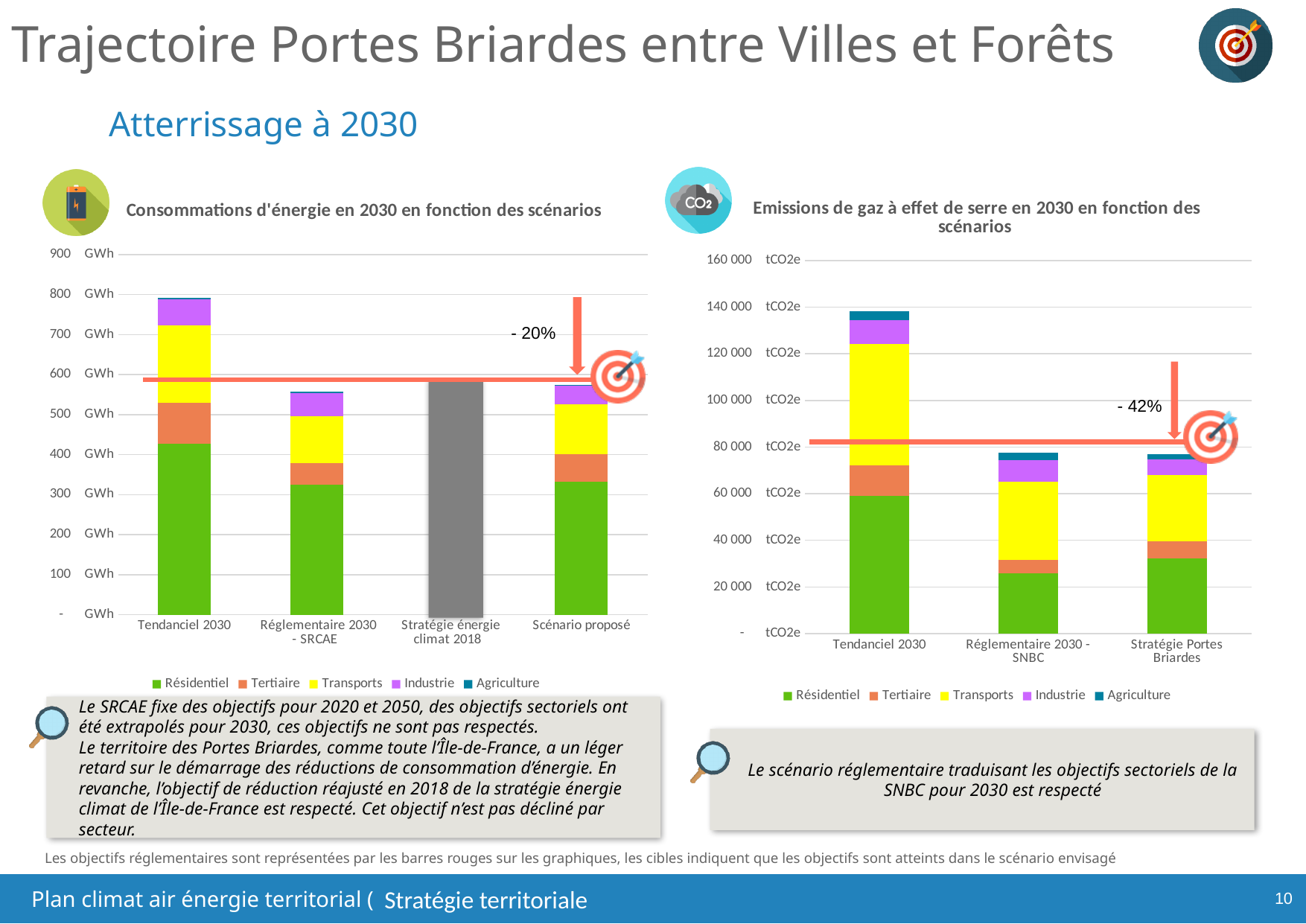
What kind of chart is the 'Consommations d'énergie en 2030 en fonction des scénarios' chart? Stacked bar chart In the 'Consommations d'énergie en 2030 en fonction des scénarios' chart, which scenario has the highest total energy consumption? Tendanciel 2030 In the 'Consommations d'énergie en 2030 en fonction des scénarios' chart, is the total for Scénario proposé greater or less than 600 GWh? less What percentage reduction is annotated with the red arrow on the 'Emissions de gaz à effet de serre en 2030 en fonction des scénarios' chart? - 42% How many series does the legend of the 'Emissions de gaz à effet de serre en 2030 en fonction des scénarios' chart list? 5 In the 'Emissions de gaz à effet de serre en 2030 en fonction des scénarios' chart, is the total for Stratégie Portes Briardes greater or less than 80 000 tCO2e? less How many scenario categories are shown on the x axis of the 'Emissions de gaz à effet de serre en 2030 en fonction des scénarios' chart? 3 In the 'Emissions de gaz à effet de serre en 2030 en fonction des scénarios' chart, which scenario has the highest total emissions? Tendanciel 2030 In the 'Emissions de gaz à effet de serre en 2030 en fonction des scénarios' chart, which has the larger total: Tendanciel 2030 or Stratégie Portes Briardes? Tendanciel 2030 In the 'Consommations d'énergie en 2030 en fonction des scénarios' chart, is the total for Tendanciel 2030 greater or less than 700 GWh? greater How many scenario categories are shown on the x axis of the 'Consommations d'énergie en 2030 en fonction des scénarios' chart? 4